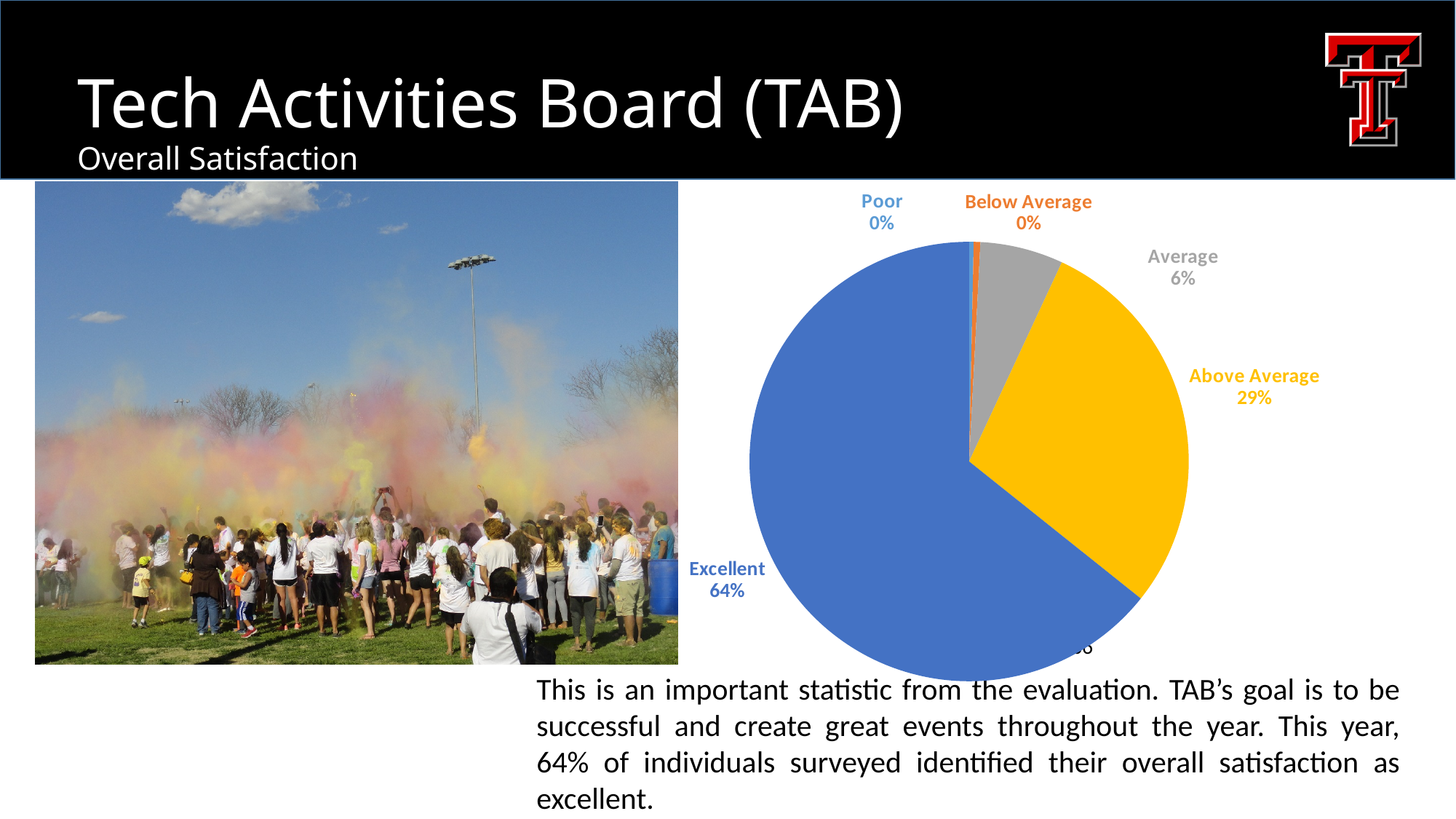
What share of respondents rated their overall satisfaction as Poor? 0% How many categories are labelled on the pie chart? 5 What colour is the Above Average slice of the pie? yellow Which is larger, the Above Average slice or the Average slice? Above Average What share of respondents rated their overall satisfaction as Average? 6% What share of respondents rated their overall satisfaction as Below Average? 0% What is the difference in percentage points between the Excellent and Above Average slices? 35 What kind of chart is shown on the slide? pie chart What share of respondents rated their overall satisfaction as Excellent? 64% What share of respondents rated their overall satisfaction as Above Average? 29% What colour is the Excellent slice of the pie? blue Which category has the largest slice of the pie? Excellent